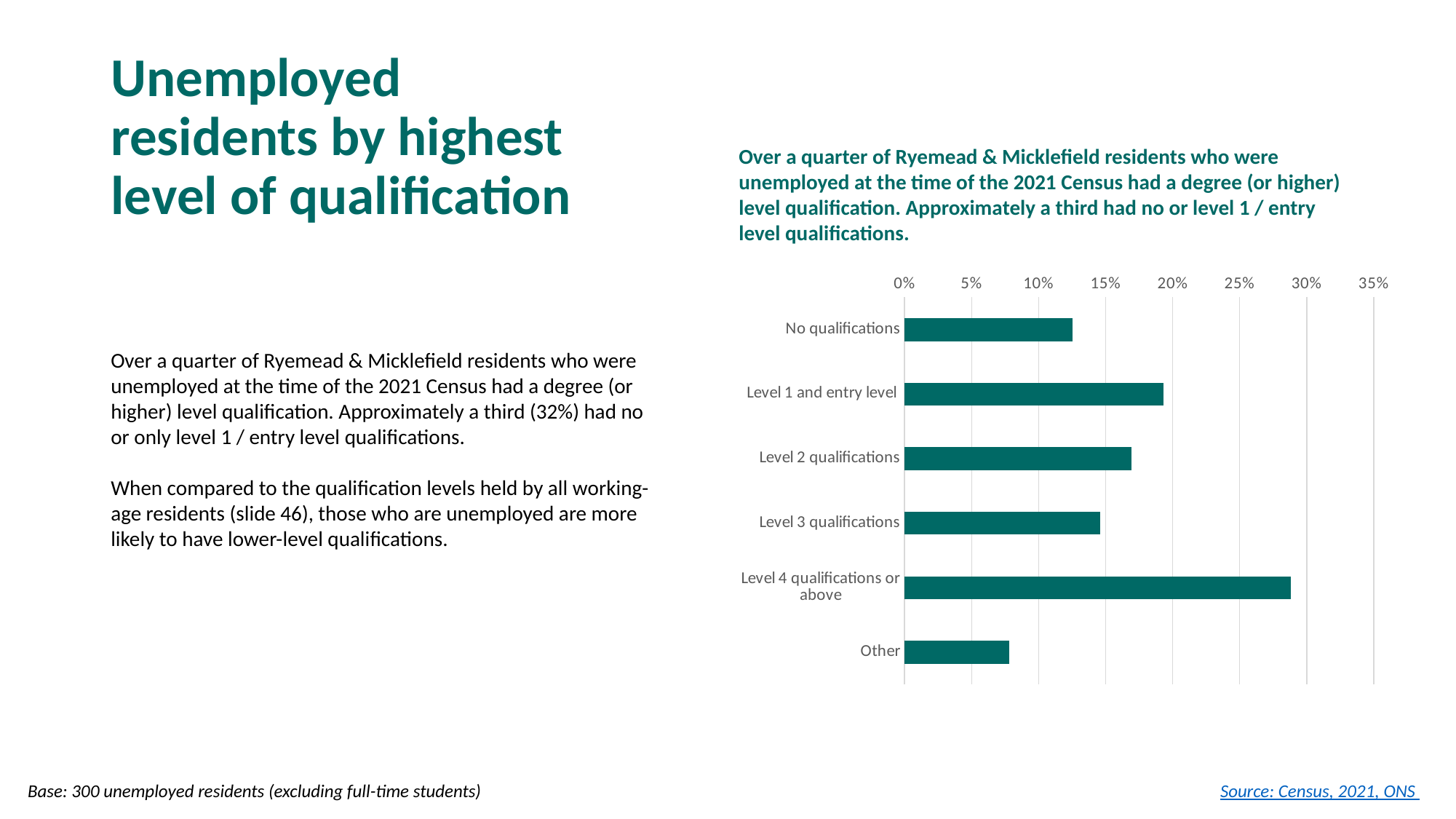
Is the value for Level 1 and entry level greater or less than 15%? greater Which is larger: the value for No qualifications or the value for Other? No qualifications What kind of chart is shown on the slide? bar chart Is the value for No qualifications greater or less than 15%? less Is the value for Level 4 qualifications or above greater or less than 25%? greater Which is larger: the value for Level 4 qualifications or above or the value for No qualifications? Level 4 qualifications or above What is the maximum value shown on the chart's percentage axis? 35% Which qualification category has the highest value in the chart? Level 4 qualifications or above Which qualification category has the lowest value in the chart? Other How many qualification categories are plotted in the chart? 6